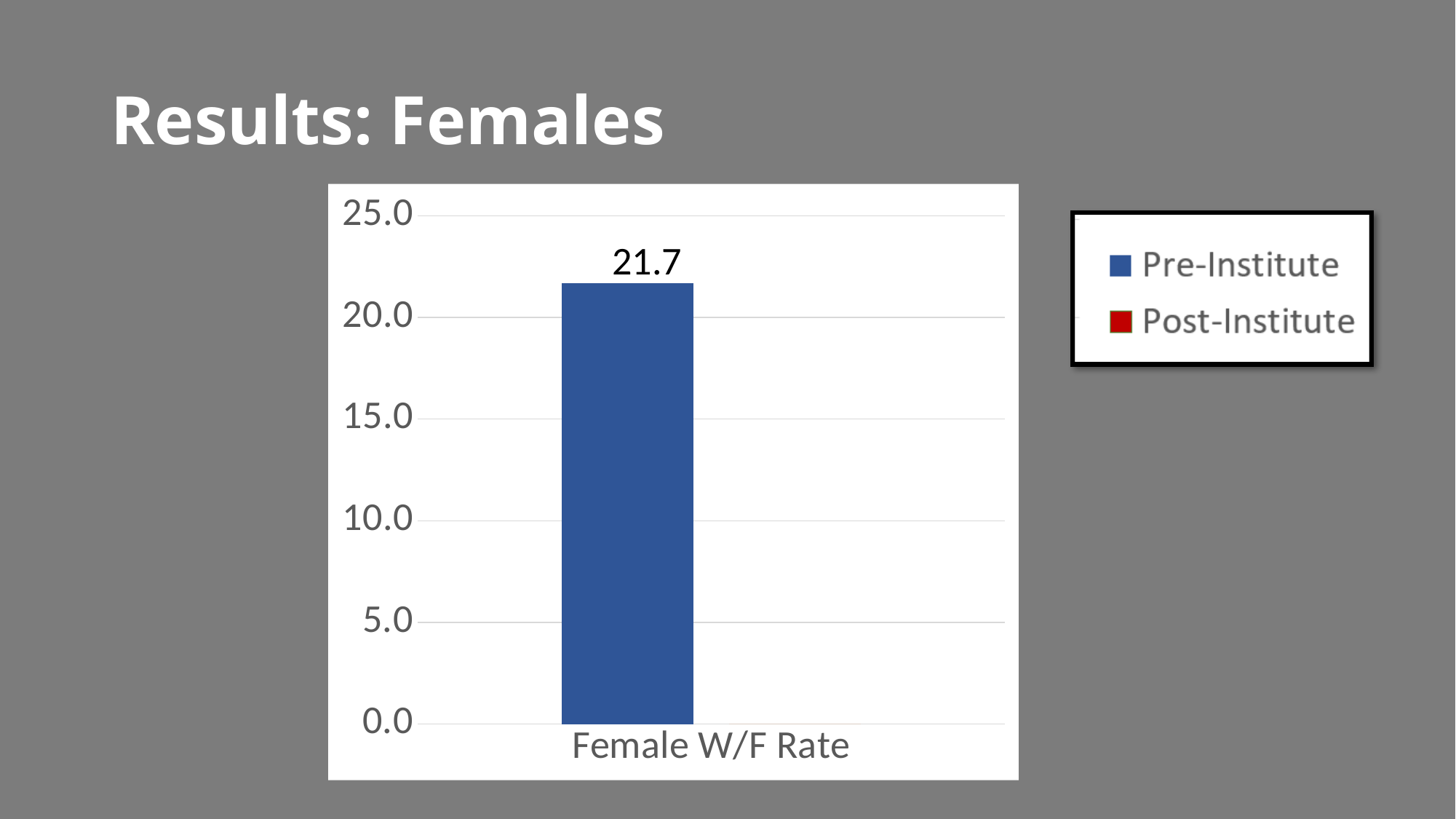
What kind of chart is shown on the slide? bar chart Is the Pre-Institute value for Female W/F Rate greater or less than 20.0? greater Is the Pre-Institute value for Female W/F Rate greater or less than 25.0? less What is the highest value shown on the y axis? 25.0 What is the label of the category on the x axis? Female W/F Rate How many series does the legend list? 2 What is the Pre-Institute value for Female W/F Rate? 21.7 How many categories are shown on the x axis? 1 What colour represents the Pre-Institute series in the legend? blue